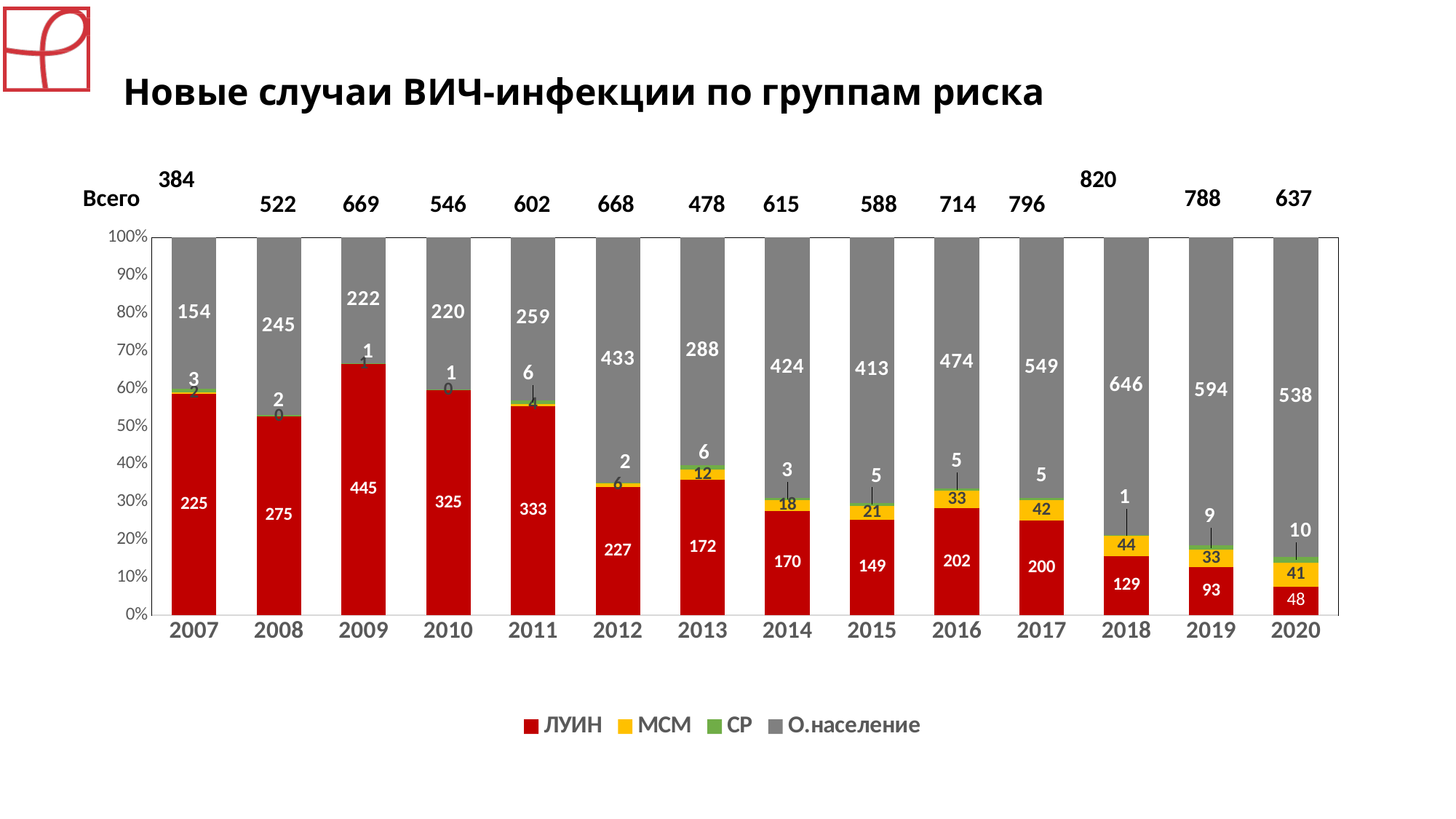
What is the value for МСМ in 2017? 42 How many years are shown on the x axis? 14 What is the value for О.население in 2018? 646 What is the value for ЛУИН in 2009? 445 In which year is the ЛУИН value lowest? 2020 Which year has the lowest total (Всего)? 2007 Which is larger, the ЛУИН value for 2012 or for 2013? 2012 How many series does the legend list? 4 Do the ЛУИН values rise or fall from 2016 to 2020? fall What is the total (Всего) shown for 2018? 820 What is the difference between the ЛУИН values for 2009 and 2020? 397 In which year is the ЛУИН value highest? 2009